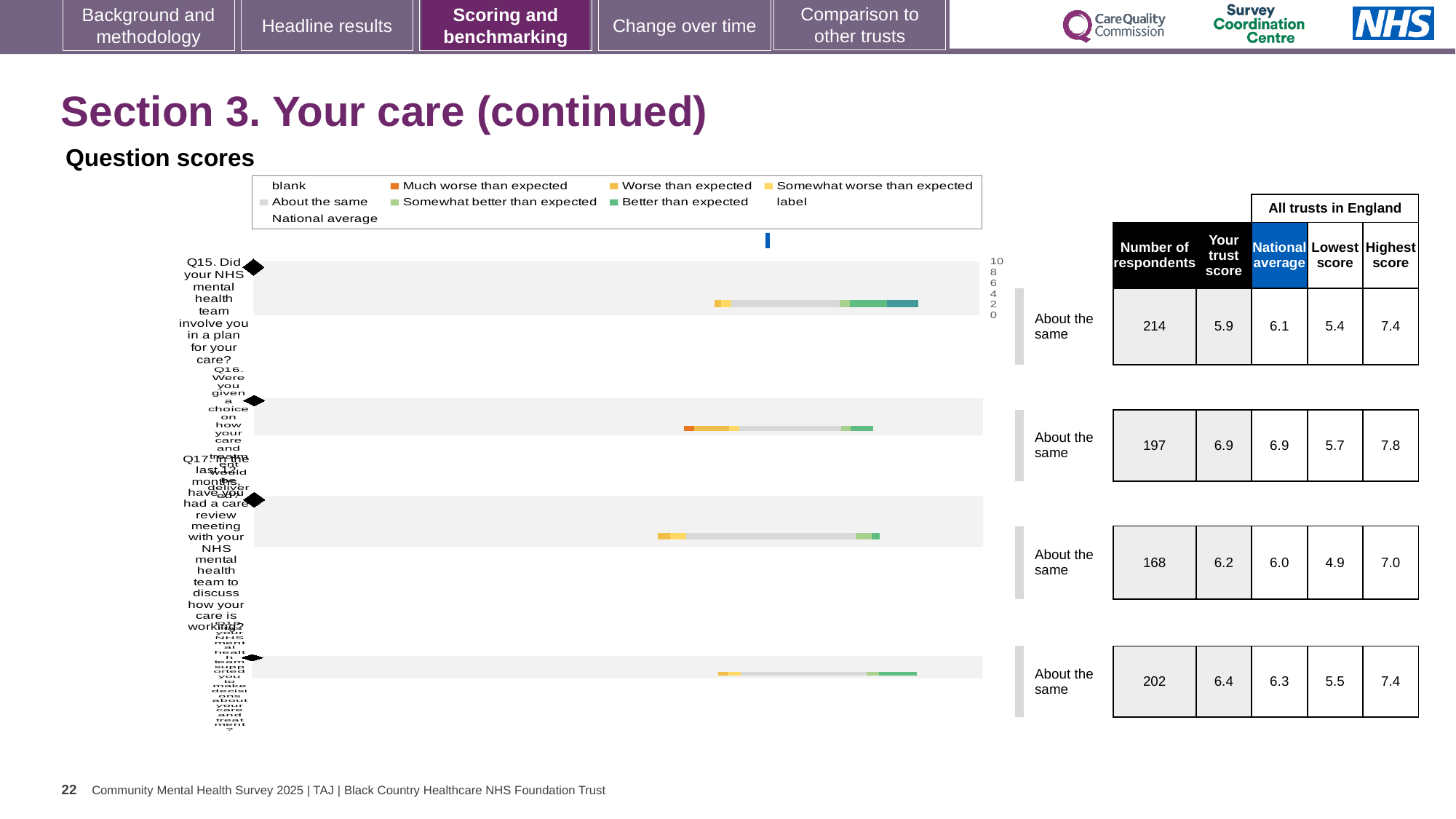
In the table beside the chart, which question has the lowest 'Lowest score'? Q17 In the table beside the chart, what is the number of respondents for Q15? 214 In the table beside the chart, is the trust score for Q16 larger or smaller than the trust score for Q15? larger Which question is plotted in the top bar of the chart? Q15. Did your NHS mental health team involve you in a plan for your care? How many question bars are plotted in the chart? 4 In the table beside the chart, what is the trust score for Q16? 6.9 What colour does the legend use for 'Much worse than expected'? orange In the table beside the chart, what is the difference between the highest score and lowest score for Q17? 2.1 In the table beside the chart, what is the national average for Q17? 6.0 In the table beside the chart, which question has the most respondents? Q15 What kind of chart is shown under 'Question scores'? bar chart In the table beside the chart, what is the highest score for Q16? 7.8